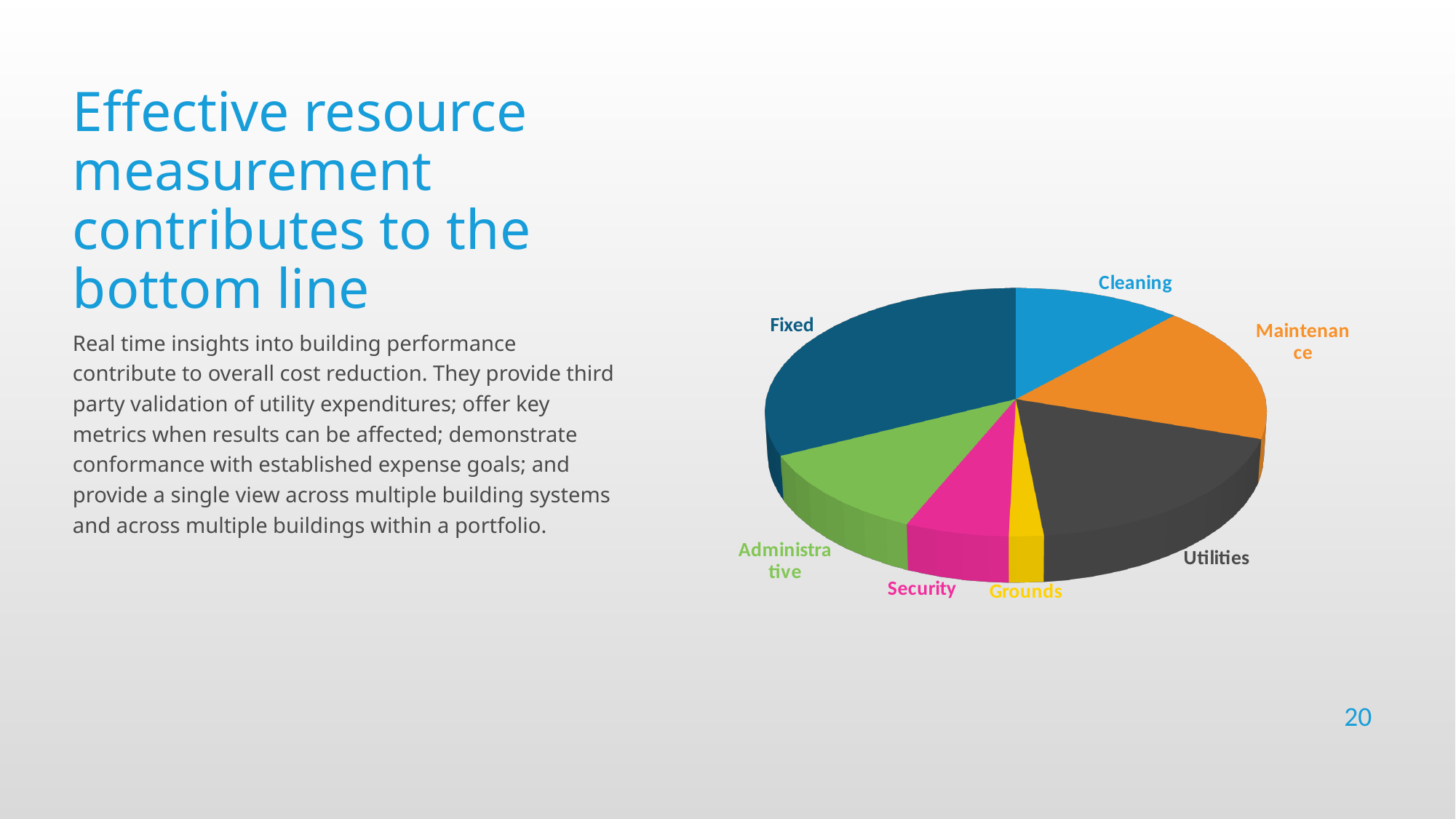
Which category is shown in the dark blue slice of the pie chart? Fixed Which category has the smallest slice of the pie chart? Grounds Which slice is larger, Grounds or Security? Security What colour is the Grounds slice in the pie chart? Yellow Which category has the largest slice of the pie chart? Fixed How many slices does the pie chart have? 7 Which slice is larger, Cleaning or Maintenance? Maintenance What kind of chart is shown on the slide? Pie chart Which slice is larger, Administrative or Grounds? Administrative